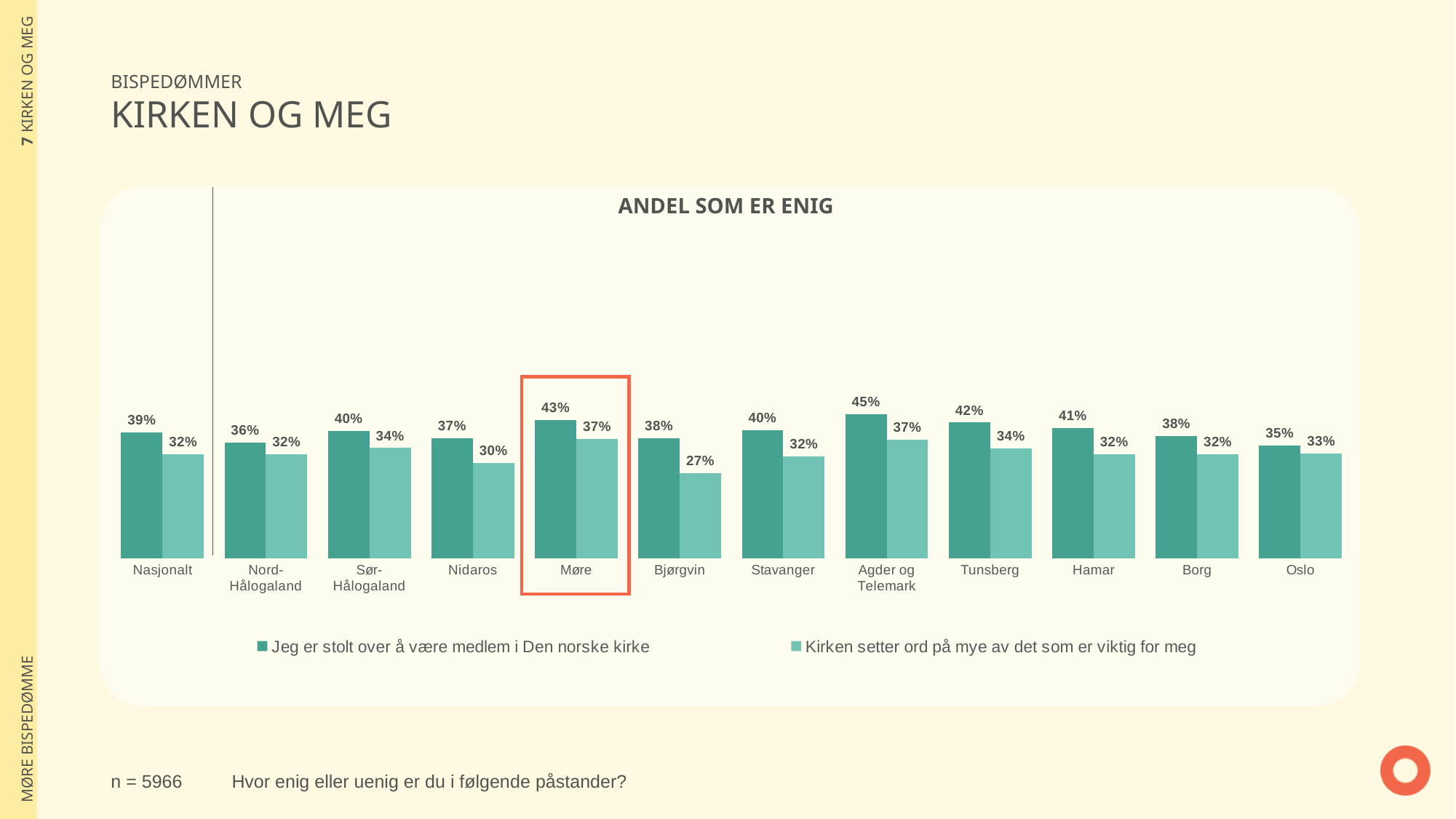
What is the title of the chart? ANDEL SOM ER ENIG Which is larger: the 'Jeg er stolt over å være medlem i Den norske kirke' value for Tunsberg or for Oslo? Tunsberg Which category is highlighted with an orange box? Møre How many series does the legend list? 2 What is the difference between the two series values for Møre? 6% What is the value for Nasjonalt in the series 'Jeg er stolt over å være medlem i Den norske kirke'? 39% Which category has the highest value in the series 'Jeg er stolt over å være medlem i Den norske kirke'? Agder og Telemark How many categories are shown on the x axis? 12 What is the value for Møre in the series 'Jeg er stolt over å være medlem i Den norske kirke'? 43% Which category has the lowest value in the series 'Kirken setter ord på mye av det som er viktig for meg'? Bjørgvin What is the value for Bjørgvin in the series 'Kirken setter ord på mye av det som er viktig for meg'? 27% What kind of chart is shown on the slide? Bar chart